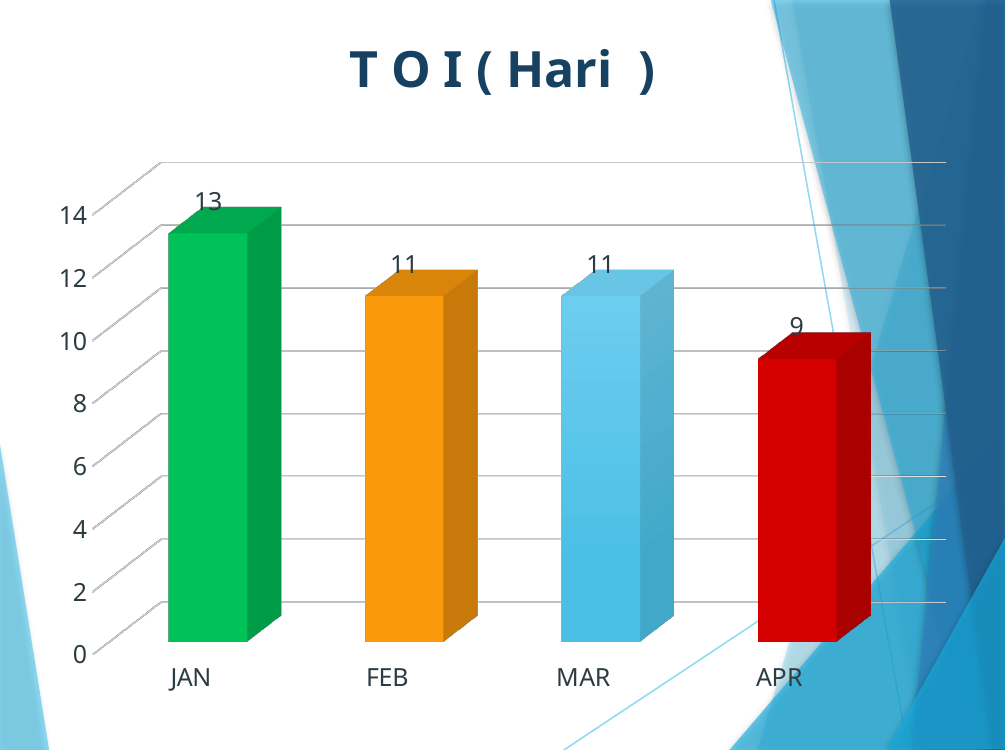
What is the value for APR? 9 What is the value for FEB? 11 Which month has the highest value? JAN Do the values generally rise or fall from JAN to APR? fall Which month has the lowest value? APR Which is larger, the value for FEB or the value for APR? FEB What is the title of the chart? T O I ( Hari ) What is the difference between the values for JAN and APR? 4 What kind of chart is shown on the slide? bar chart What is the difference between the values for JAN and MAR? 2 What is the value for JAN? 13 How many months are shown on the x axis? 4